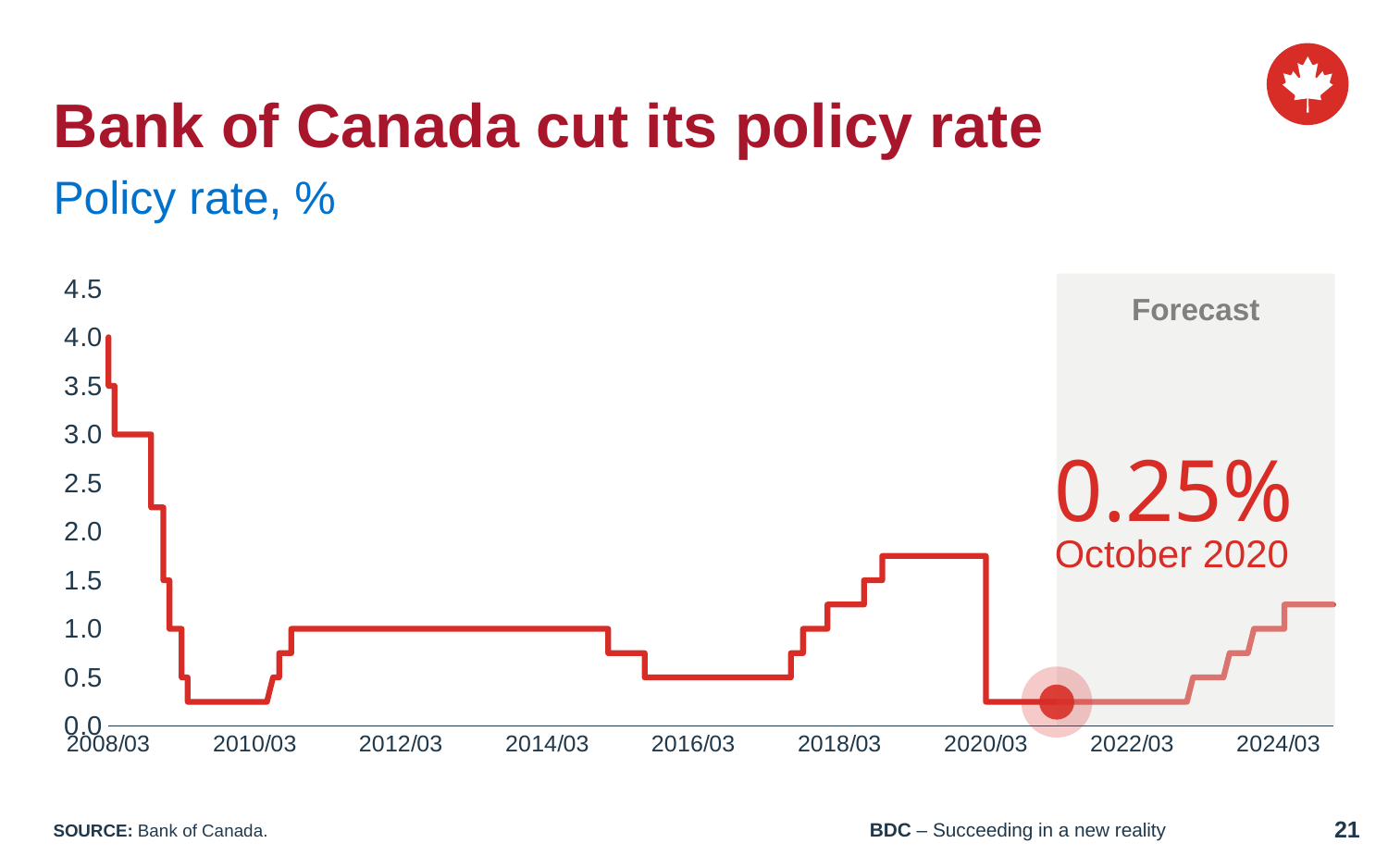
What type of chart is shown on the slide? line chart Which is higher, the policy rate at 2008/03 or at 2020/03? 2008/03 What label appears in the shaded region on the right side of the chart? Forecast At which point on the x axis is the policy rate highest? 2008/03 Is the policy rate at 2012/03 greater or less than 0.5? greater Is the policy rate at 2016/03 greater or less than 1.0? less What policy rate value is highlighted for October 2020? 0.25% Is the policy rate in early 2019 greater or less than 1.5? greater Does the policy rate rise or fall between 2008/03 and 2010/03? fall What is the title of the chart? Bank of Canada cut its policy rate